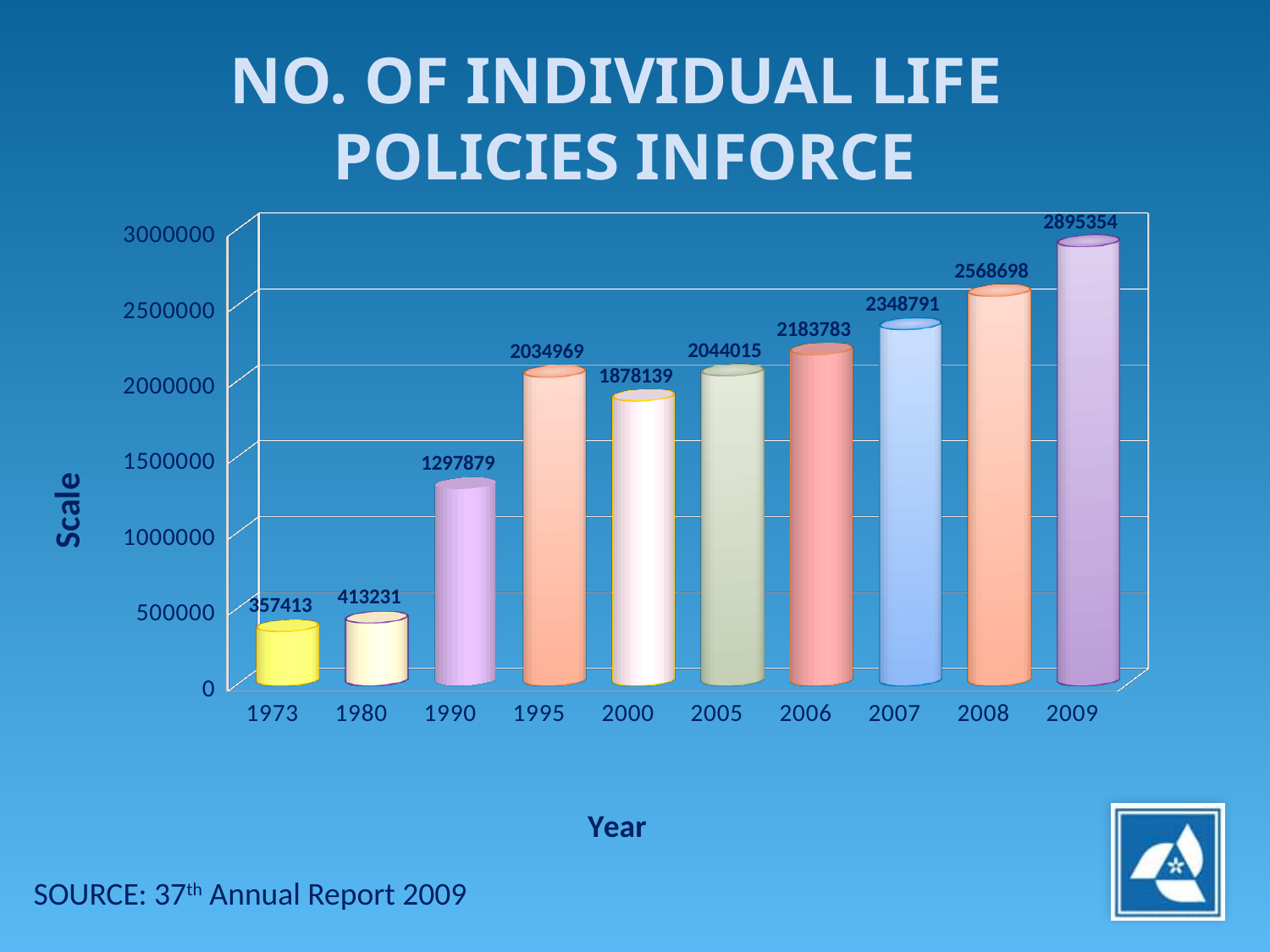
Is the value for 2007 greater or less than 2000000? greater What is the number of individual life policies in force for 2009? 2895354 What is the value for 2000? 1878139 What value is shown for the year 1990? 1297879 What kind of chart is shown on the slide? bar chart What is the difference between the values for 2009 and 2008? 326656 How many years are shown on the x axis? 10 Which year has the larger value, 1995 or 2000? 1995 Which year has the highest number of policies in force? 2009 What is the label of the y axis? Scale Which year has the lowest number of policies in force? 1973 What is the difference between the values for 1980 and 1973? 55818